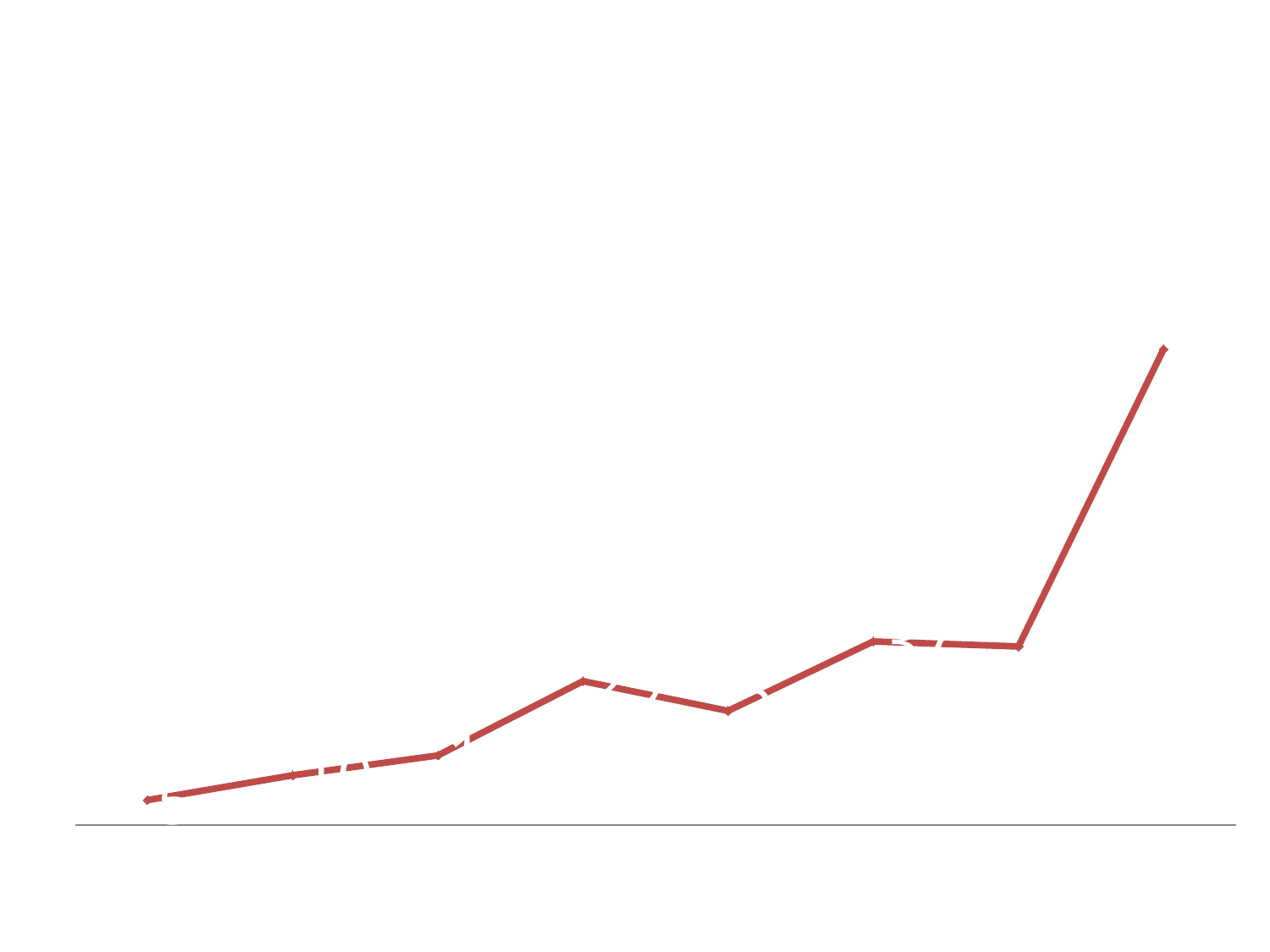
How many data points are plotted on the line? 8 What colour is the plotted line? red What kind of chart is shown on the slide? line chart Is the highest point on the line at the left end or the right end of the chart? right end Is the lowest point on the line at the left end or the right end of the chart? left end How many lines are plotted on the chart? 1 Do the values generally rise or fall from left to right along the x axis? rise